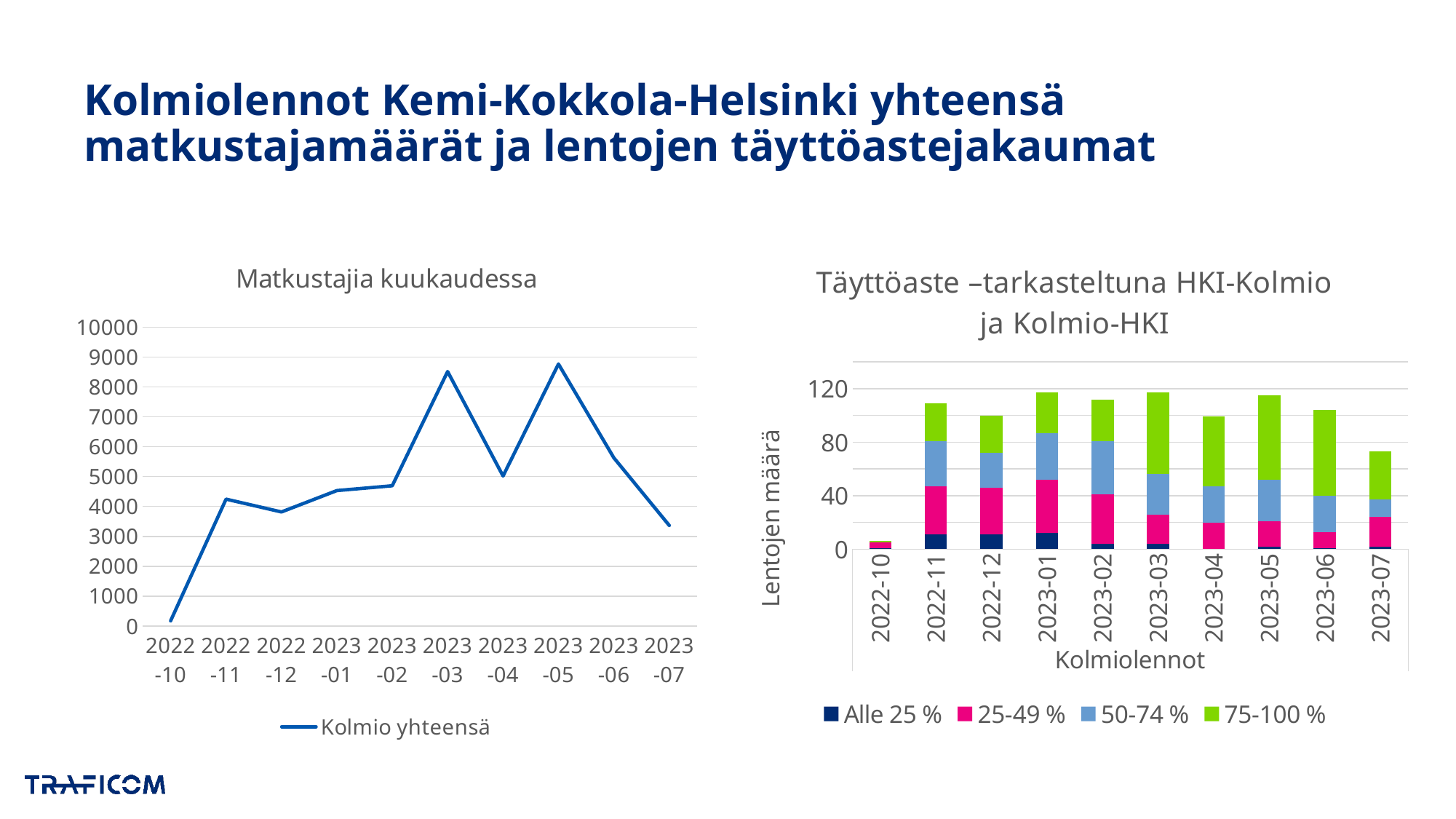
In the left chart "Matkustajia kuukaudessa", is the value for 2023-03 greater or less than 8000? greater What kind of chart is the right chart titled "Täyttöaste –tarkasteltuna HKI-Kolmio ja Kolmio-HKI"? bar chart How many series does the legend of the right chart "Täyttöaste" list? 4 In the left chart "Matkustajia kuukaudessa", is the value for 2023-07 greater or less than 4000? less In the left chart "Matkustajia kuukaudessa", do the values rise or fall from 2023-05 to 2023-07? fall What kind of chart is the left chart titled "Matkustajia kuukaudessa"? line chart In the left chart "Matkustajia kuukaudessa", which is larger, the value for 2023-03 or 2023-04? 2023-03 In the left chart "Matkustajia kuukaudessa", how many months are plotted on the x axis? 10 What is the name of the series in the legend of the left chart "Matkustajia kuukaudessa"? Kolmio yhteensä In the right chart "Täyttöaste", which month has the lowest total number of flights? 2022-10 In the left chart "Matkustajia kuukaudessa", which month has the lowest value? 2022-10 In the right chart "Täyttöaste", is the total bar height for 2023-07 greater or less than 80? less